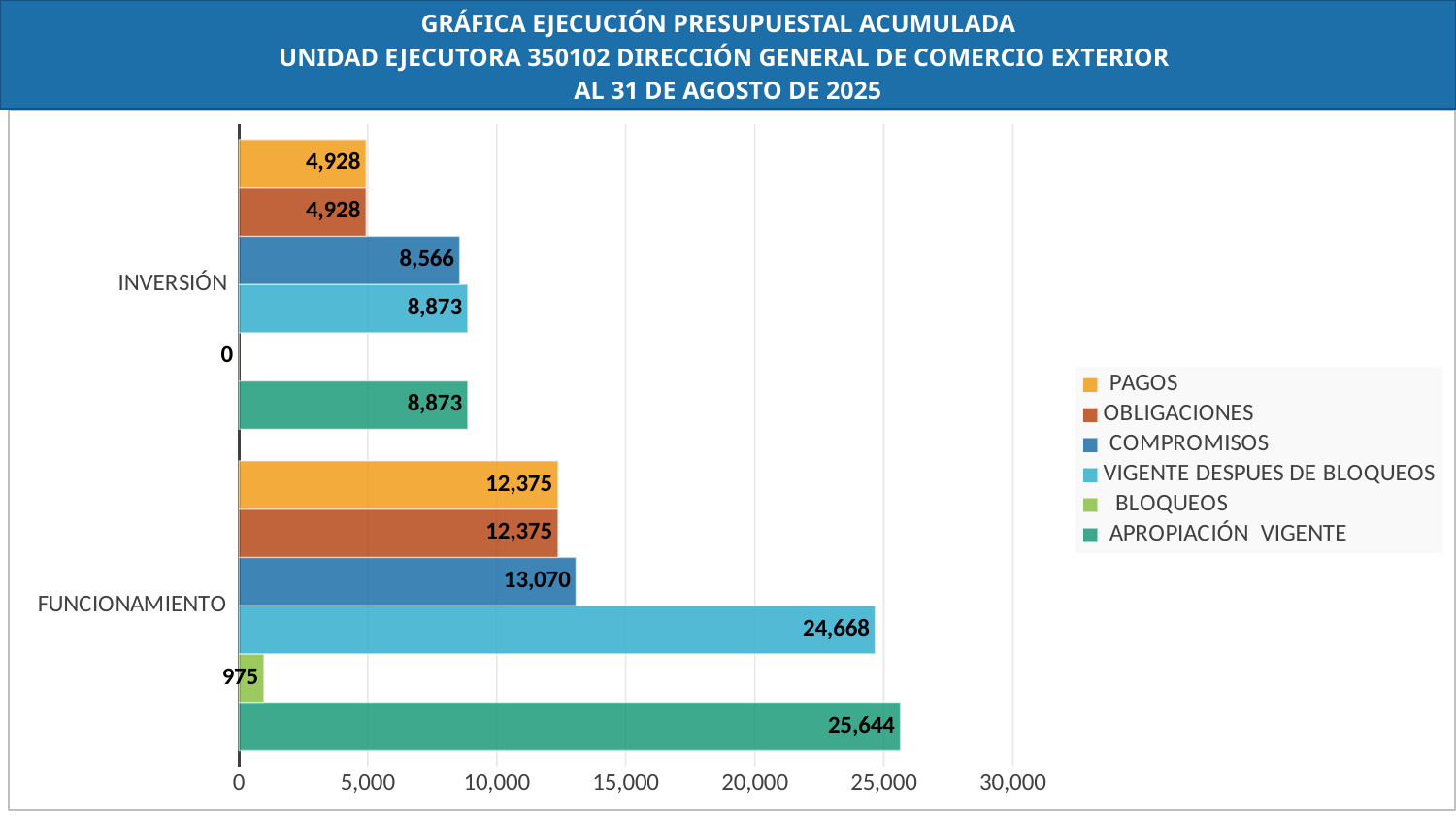
How many series does the legend list? 6 Which series has the lowest value for INVERSIÓN? BLOQUEOS Which is larger: COMPROMISOS for FUNCIONAMIENTO or COMPROMISOS for INVERSIÓN? COMPROMISOS for FUNCIONAMIENTO What is the value of VIGENTE DESPUES DE BLOQUEOS for FUNCIONAMIENTO? 24,668 What is the value of PAGOS for INVERSIÓN? 4,928 What is the value of APROPIACIÓN VIGENTE for FUNCIONAMIENTO? 25,644 Which series has the highest value for FUNCIONAMIENTO? APROPIACIÓN VIGENTE What is the value of BLOQUEOS for FUNCIONAMIENTO? 975 What is the value of COMPROMISOS for INVERSIÓN? 8,566 What kind of chart is shown on the slide? Bar chart How many categories are shown on the vertical axis? 2 What is the difference between APROPIACIÓN VIGENTE and VIGENTE DESPUES DE BLOQUEOS for FUNCIONAMIENTO? 976